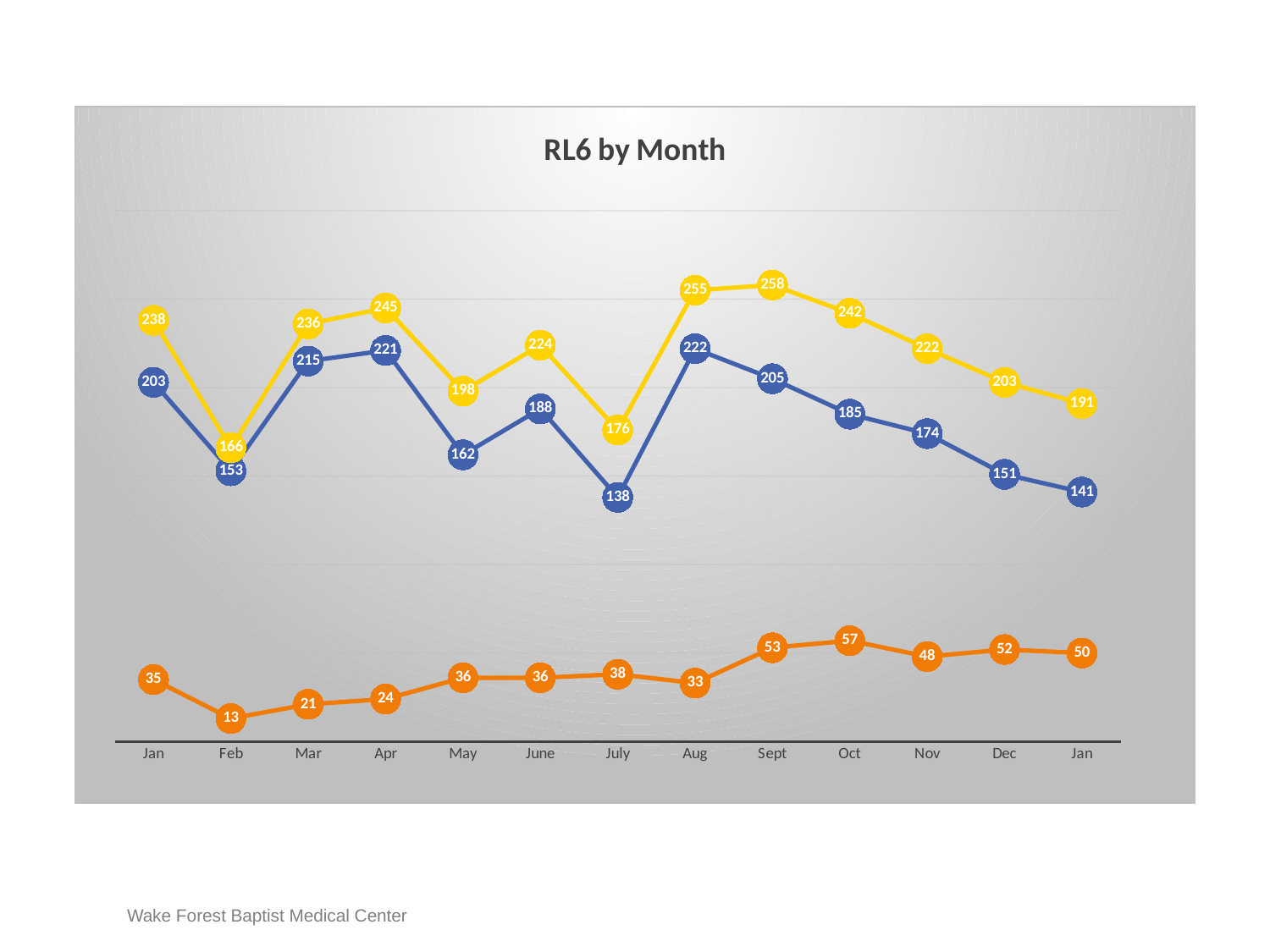
In which month does the yellow line reach its highest value? Sept What type of chart is shown on the slide? line chart What is the value of the orange line in Feb? 13 How many months are shown along the x axis of the chart? 13 What is the title of the chart? RL6 by Month From Sept to the final Jan, does the blue line rise or fall? fall What is the difference between the yellow line and the blue line in Aug? 33 Which is larger in Oct: the value of the blue line or the value of the orange line? the blue line In which month does the blue line reach its lowest value? July What is the value of the blue line in July? 138 What is the value of the yellow line in Sept? 258 How many lines (series) are plotted on the chart? 3